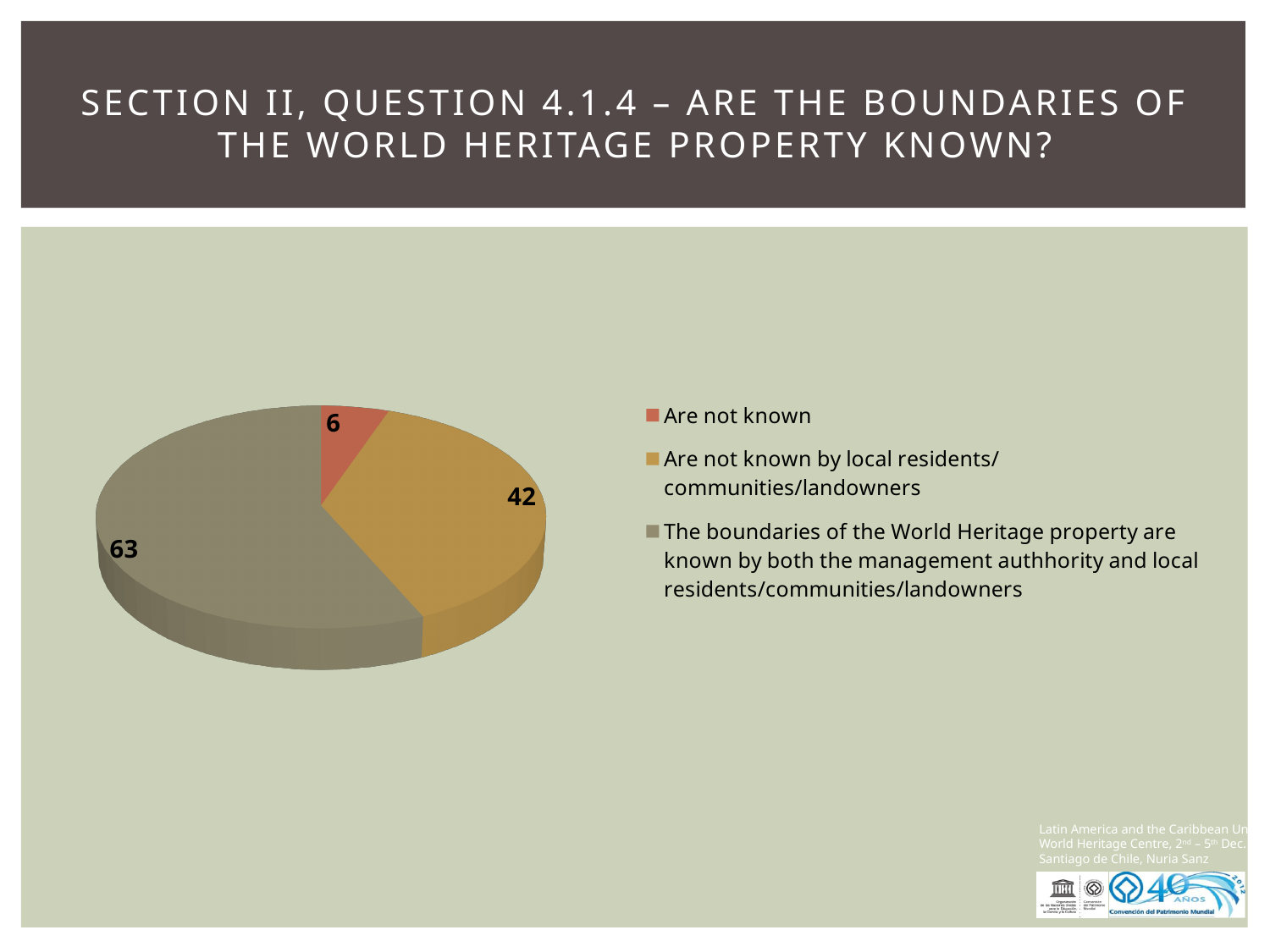
What is the value for the slice 'The boundaries of the World Heritage property are known by both the management authhority and local residents/communities/landowners'? 63 What type of chart is shown on the slide? Pie chart What is the difference between the largest slice (63) and the 'Are not known by local residents/communities/landowners' slice (42)? 21 What is the value for the 'Are not known by local residents/communities/landowners' slice? 42 How many slices does the pie chart have? 3 Which category has the smallest slice of the pie? Are not known What is the total of all the slice values in the pie chart? 111 What colour is the slice for 'Are not known'? Red Which category has the largest slice of the pie? The boundaries of the World Heritage property are known by both the management authhority and local residents/communities/landowners What share of the total does the 'Are not known' slice represent, as a fraction of the total? 6 out of 111 What is the value for the 'Are not known' slice? 6 Which is larger: the 'Are not known' slice or the 'Are not known by local residents/communities/landowners' slice? Are not known by local residents/communities/landowners